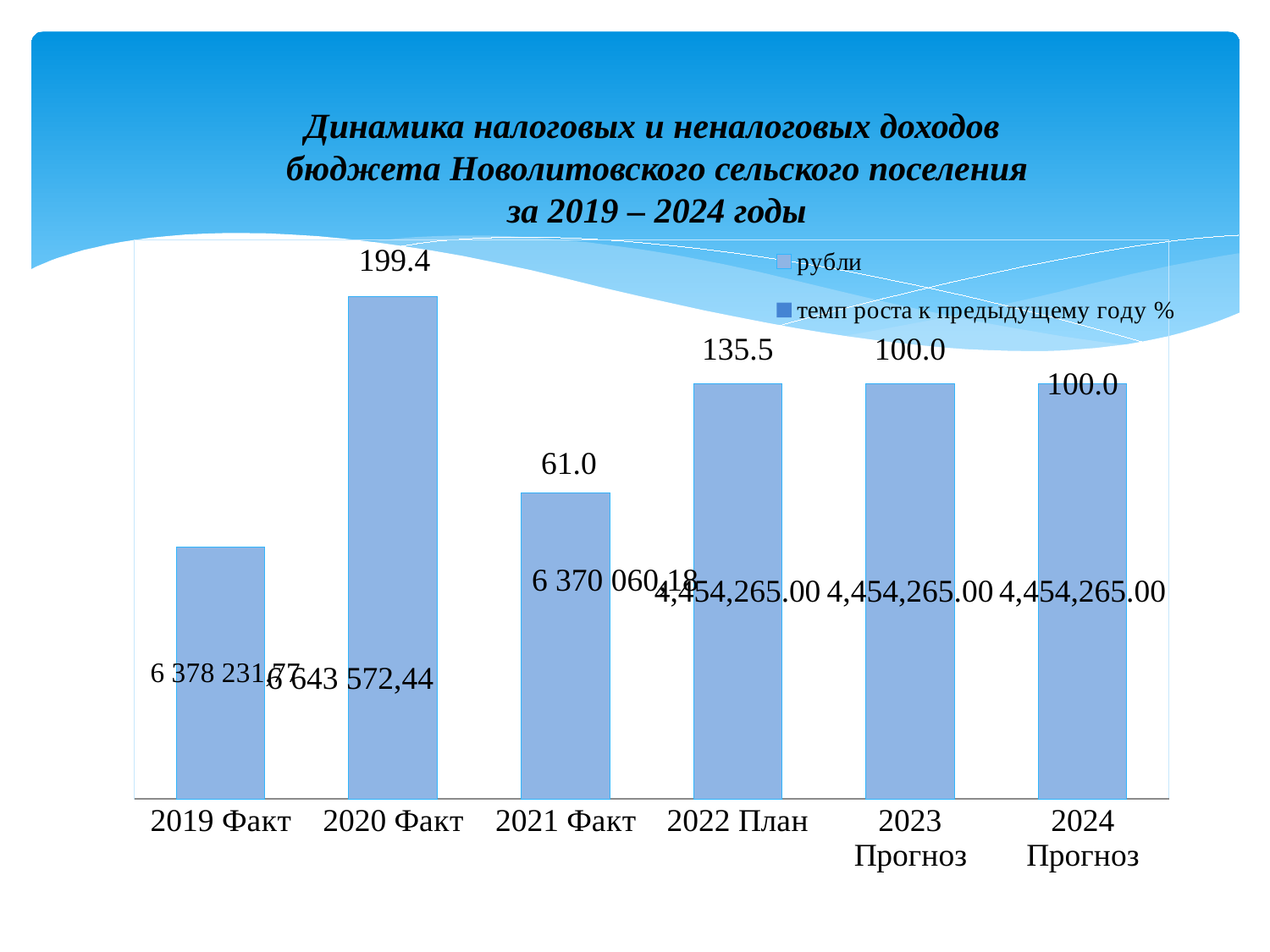
Which category has the highest growth rate to the previous year? 2020 Факт Which has the larger growth rate to the previous year, 2020 Факт or 2022 План? 2020 Факт What is the ruble value (рубли) for 2022 План? 4,454,265.00 How many categories are shown along the x axis? 6 What is the growth rate to the previous year (темп роста) for 2022 План? 135.5 Among the printed growth rate values, which category has the lowest? 2021 Факт How many series does the legend list? 2 What is the ruble value (рубли) for 2021 Факт? 6 370 060,18 What kind of chart is shown on the slide? Bar chart What is the growth rate to the previous year (темп роста) for 2020 Факт? 199.4 What is the growth rate to the previous year (темп роста) for 2021 Факт? 61.0 What is the difference between the growth rates for 2020 Факт and 2021 Факт? 138.4